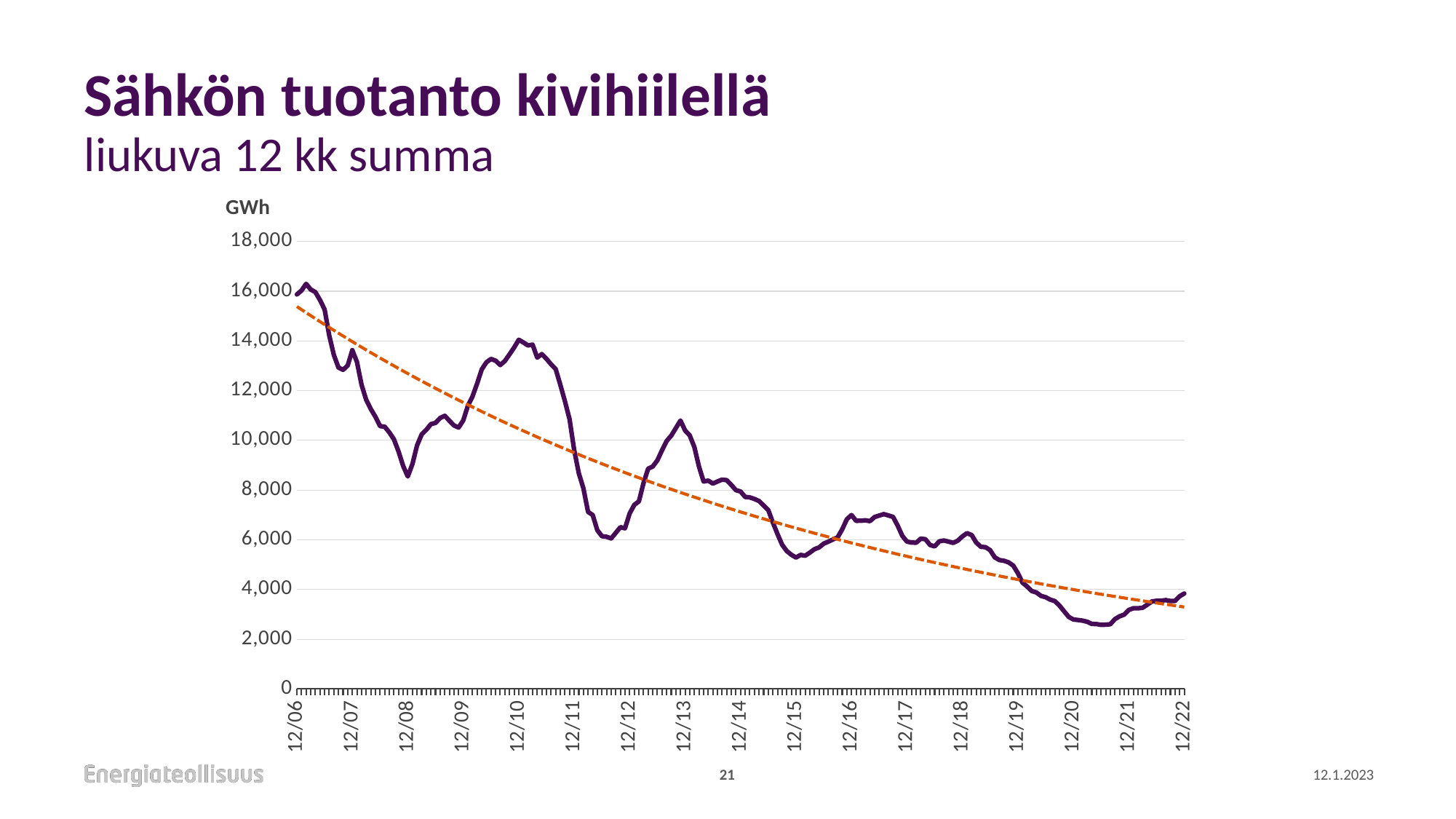
Overall, do the values rise or fall from 12/06 to 12/22? fall Near which x-axis label is the plotted value highest? 12/06 Is the value at 12/20 greater or less than 4,000? less Is the value at 12/08 greater or less than 10,000? less Is the value at 12/10 greater or less than 12,000? greater How many labels are shown on the x axis of the chart? 17 What unit is shown on the vertical axis of the chart? GWh What is the title of the chart on the slide? Sähkön tuotanto kivihiilellä What kind of chart is shown on the slide? line chart Which is larger, the value at 12/10 or the value at 12/13? 12/10